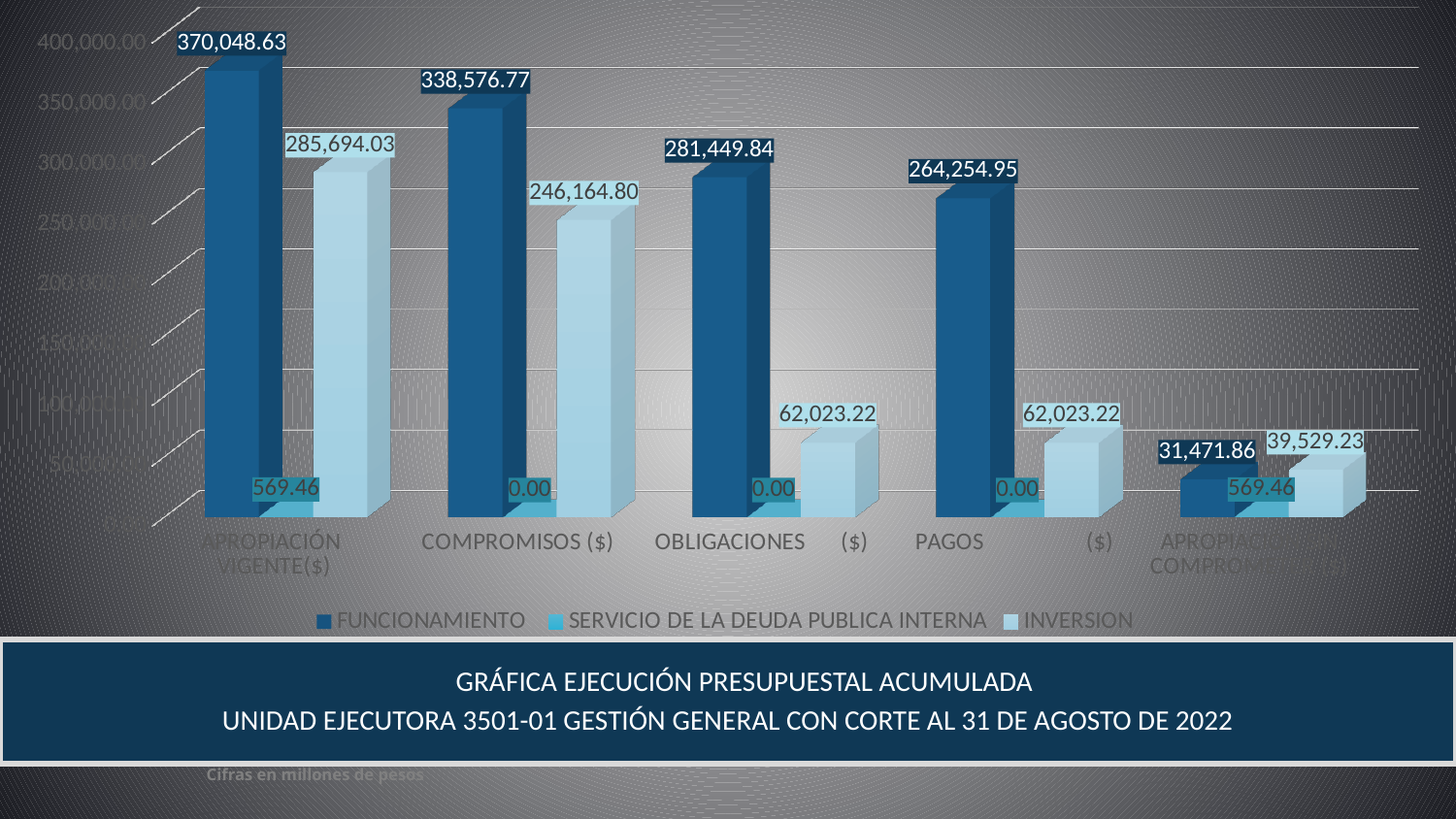
What kind of chart is shown on the slide? bar chart How many series does the legend list? 3 What is the INVERSION value for PAGOS ($)? 62,023.22 Which has the larger INVERSION value, COMPROMISOS ($) or OBLIGACIONES ($)? COMPROMISOS ($) Which category has the highest FUNCIONAMIENTO value? APROPIACIÓN VIGENTE($) What is the INVERSION value for APROPIACIÓN VIGENTE($)? 285,694.03 What is the FUNCIONAMIENTO value for COMPROMISOS ($)? 338,576.77 Do the FUNCIONAMIENTO values rise or fall from left to right across the categories? fall What is the difference between the FUNCIONAMIENTO values for OBLIGACIONES ($) and PAGOS ($)? 17,194.89 How many categories are shown on the x axis? 5 What is the SERVICIO DE LA DEUDA PUBLICA INTERNA value for APROPIACIÓN VIGENTE($)? 569.46 What is the difference between the FUNCIONAMIENTO values for APROPIACIÓN VIGENTE($) and COMPROMISOS ($)? 31,471.86